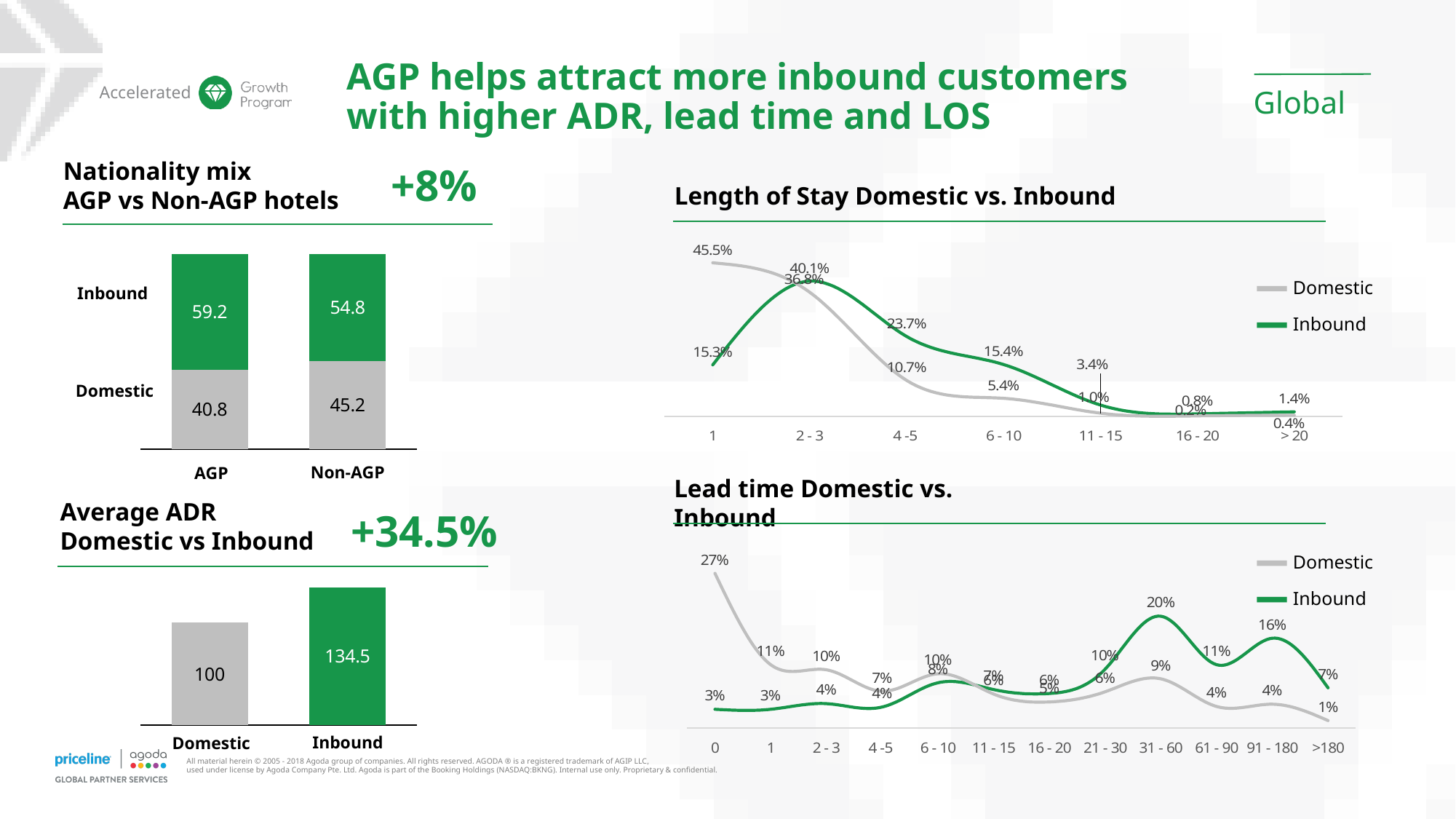
In the Nationality mix AGP vs Non-AGP hotels chart, what is the total of the AGP stacked bar? 100 In the Nationality mix AGP vs Non-AGP hotels chart, what is the difference between the Inbound values for AGP and Non-AGP? 4.4 In the Nationality mix AGP vs Non-AGP hotels chart, what is the Inbound value for AGP? 59.2 In the Lead time Domestic vs. Inbound chart, what is the Domestic value at 0? 27% How many categories are on the x axis of the Length of Stay Domestic vs. Inbound chart? 7 In the Lead time Domestic vs. Inbound chart, what is the Inbound value for 31 - 60? 20% In the Length of Stay Domestic vs. Inbound chart, what is the Inbound value for 4 -5? 23.7% In the Average ADR Domestic vs Inbound chart, what is the value for Inbound? 134.5 In the Nationality mix AGP vs Non-AGP hotels chart, what is the Domestic value for Non-AGP? 45.2 In the Average ADR Domestic vs Inbound chart, which category has the higher value? Inbound What kind of chart is the Average ADR Domestic vs Inbound chart? Bar chart In the Length of Stay Domestic vs. Inbound chart, what is the Domestic value for a length of stay of 1? 45.5%